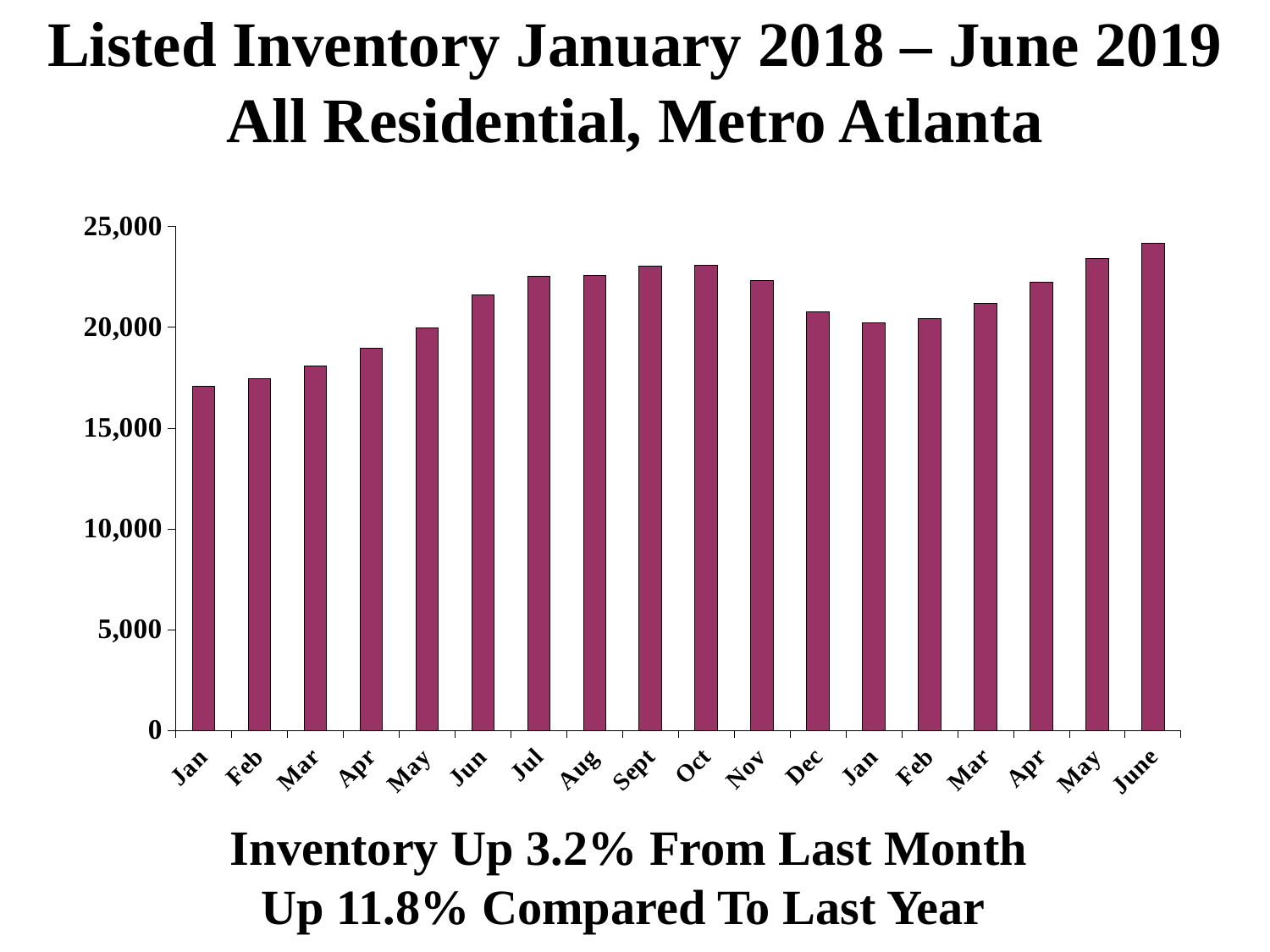
What kind of chart is shown on the slide? Bar chart Is the value for the first Jan bar (January 2018) greater or less than 20,000? less How many bars (months) are plotted in the chart? 18 Is the value for Oct greater or less than 25,000? less Which month has the highest listed inventory in the chart? June (2019, the last bar) Is the value for the first Jan bar (January 2018) greater or less than 15,000? greater Which month has the lowest listed inventory in the chart? Jan (2018, the first bar) Which is larger, the first Jan bar (January 2018) or the second Jan bar (January 2019)? The second Jan bar (January 2019) Do the values rise or fall from Jan 2018 through Oct 2018? Rise Which is larger, the first Mar bar (March 2018) or the second Mar bar (March 2019)? The second Mar bar (March 2019) What is the title of the chart? Listed Inventory January 2018 – June 2019 All Residential, Metro Atlanta